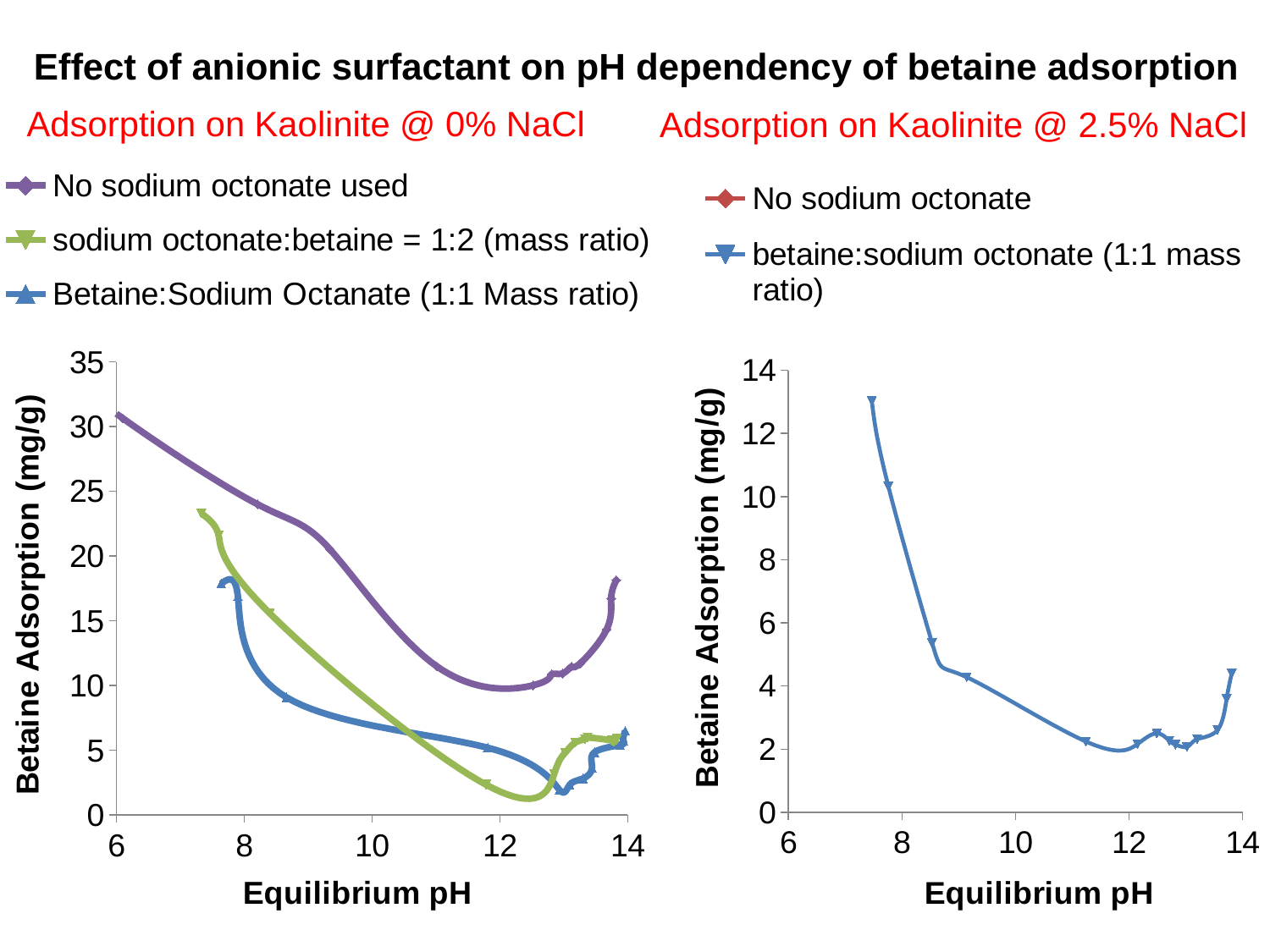
In the 'Adsorption on Kaolinite @ 0% NaCl' chart, does the 'No sodium octonate used' series rise or fall between pH 6 and pH 12? Fall In the 'Adsorption on Kaolinite @ 0% NaCl' chart, which series reaches the highest betaine adsorption value? No sodium octonate used What is the y-axis label on the 'Adsorption on Kaolinite @ 0% NaCl' chart? Betaine Adsorption (mg/g) How many series does the legend of the 'Adsorption on Kaolinite @ 2.5% NaCl' chart list? 2 In the 'Adsorption on Kaolinite @ 0% NaCl' chart, is the value for 'No sodium octonate used' at pH 6 greater or less than 25? greater In the 'Adsorption on Kaolinite @ 2.5% NaCl' chart, is the first plotted value of the 'betaine:sodium octonate (1:1 mass ratio)' series greater or less than 12? greater In the 'Adsorption on Kaolinite @ 2.5% NaCl' chart, does the plotted series rise or fall between pH 8 and pH 12? Fall In the 'Adsorption on Kaolinite @ 2.5% NaCl' chart, is the value of the 'betaine:sodium octonate (1:1 mass ratio)' series at pH 12 greater or less than 4? less What is the x-axis label on the 'Adsorption on Kaolinite @ 2.5% NaCl' chart? Equilibrium pH How many series does the legend of the 'Adsorption on Kaolinite @ 0% NaCl' chart list? 3 In the 'Adsorption on Kaolinite @ 0% NaCl' chart, at pH 8, which series has the higher value: 'No sodium octonate used' or 'Betaine:Sodium Octanate (1:1 Mass ratio)'? No sodium octonate used What kind of chart is the 'Adsorption on Kaolinite @ 0% NaCl' chart? Line chart